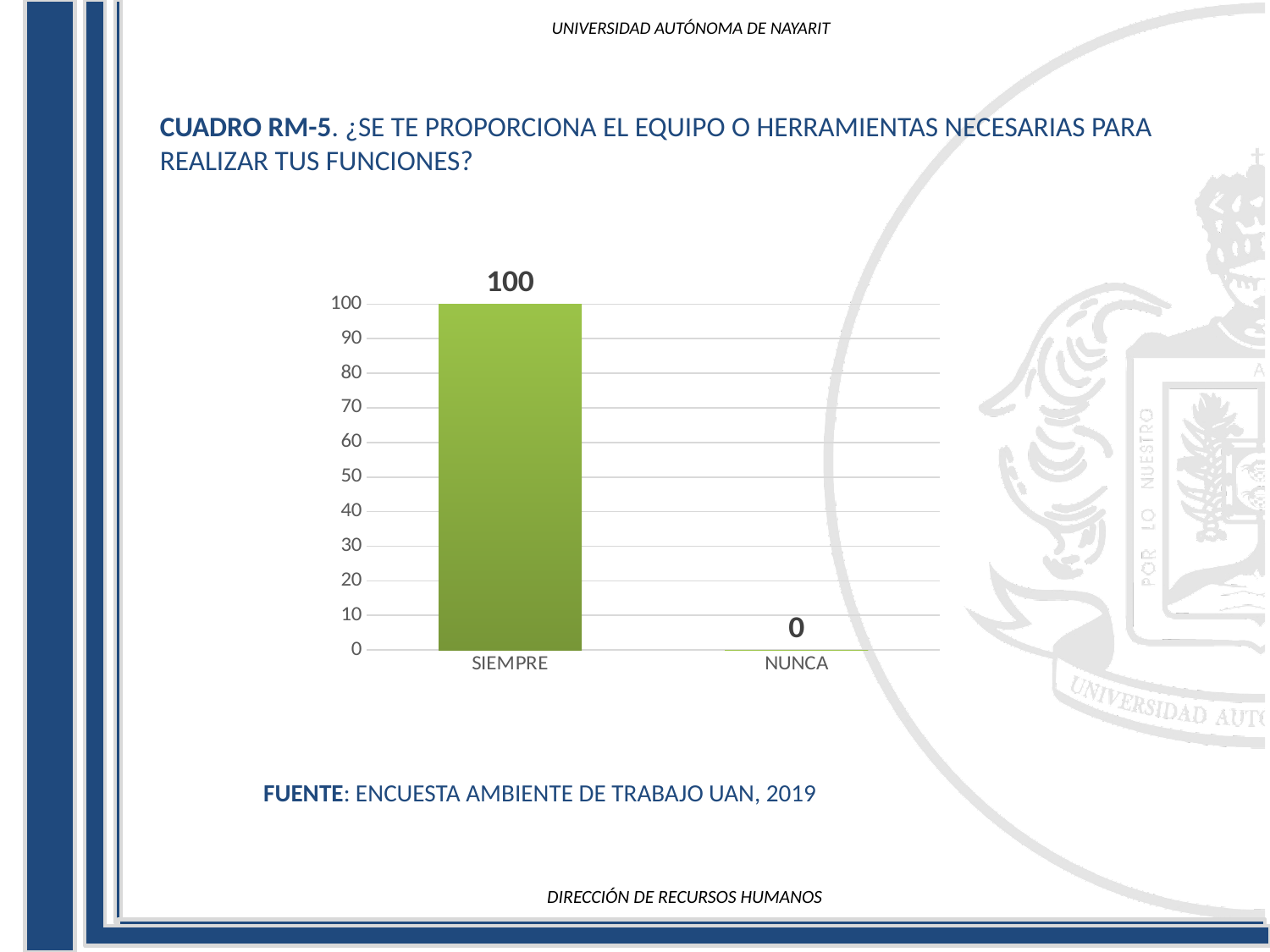
What is the value for NUNCA? 0 What kind of chart is shown on the slide? bar chart Do the values rise or fall from SIEMPRE to NUNCA? fall Which is larger, the value for SIEMPRE or the value for NUNCA? SIEMPRE How many categories are shown on the x axis? 2 Which category has the highest value? SIEMPRE Which category has the lowest value? NUNCA What is the value for SIEMPRE? 100 What is the difference between the values for SIEMPRE and NUNCA? 100 What is the highest tick value shown on the vertical axis? 100 What colour is the bar for SIEMPRE? green Is the value for SIEMPRE greater or less than 50? greater